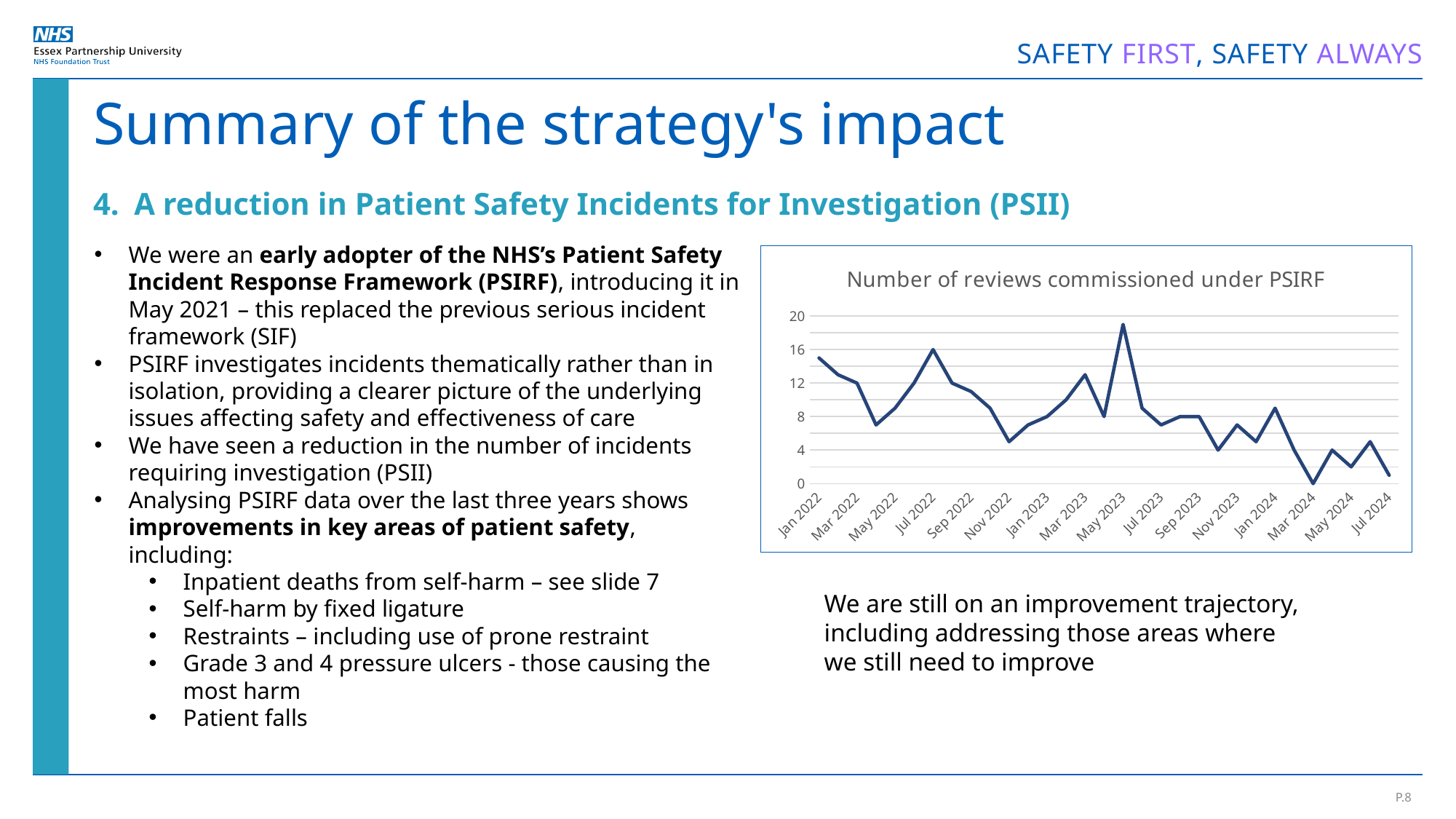
Overall, do the values rise or fall from Jan 2022 to Jul 2024? fall What kind of chart is shown on the slide? line chart Which is larger, the value for Jan 2022 or the value for Jul 2024? Jan 2022 Is the value for May 2023 greater or less than 16? greater Is the value for Mar 2024 greater or less than 4? less What is the title of the chart? Number of reviews commissioned under PSIRF Is the value for Jul 2024 greater or less than 4? less How many month labels are shown on the x axis of the chart? 16 In which month does the number of reviews commissioned under PSIRF reach its lowest point? Mar 2024 In which month does the number of reviews commissioned under PSIRF reach its highest point? May 2023